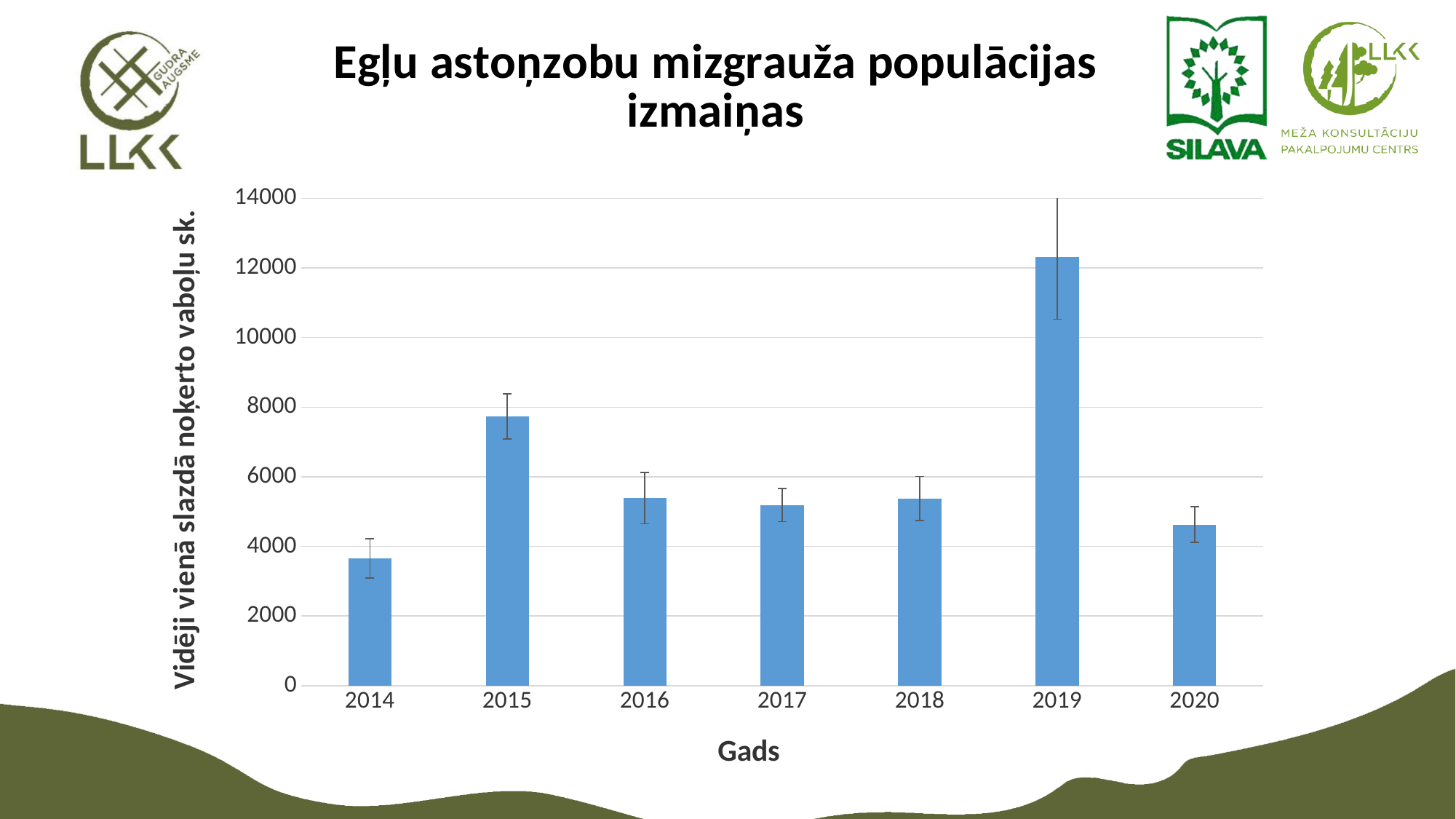
Which year has the highest value in the chart? 2019 Which year has the lowest value in the chart? 2014 Which is larger, the value for 2020 or the value for 2014? 2020 Is the value for 2014 greater or less than 4000? less Is the value for 2019 greater or less than 10000? greater What kind of chart is shown on the slide? bar chart Is the value for 2020 greater or less than 4000? greater Which is larger, the value for 2015 or the value for 2016? 2015 What is the label of the x axis of the chart? Gads Does the value rise or fall from 2019 to 2020? fall How many years are shown on the x axis of the chart? 7